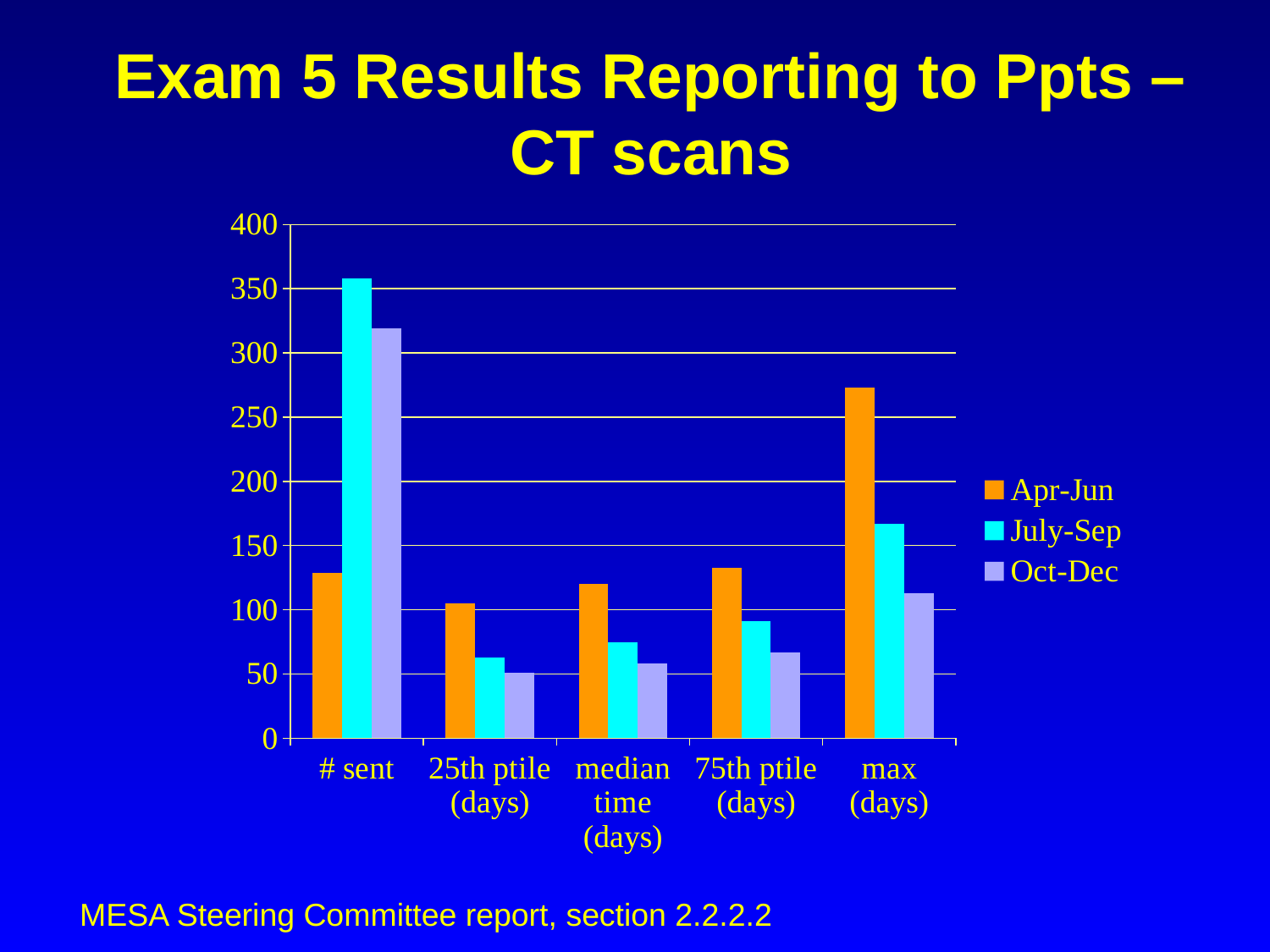
What is the title of the slide? Exam 5 Results Reporting to Ppts – CT scans Is the Apr-Jun value for 'max (days)' greater or less than 250? greater How many series does the legend list? 3 Which series has the lowest value for '# sent'? Apr-Jun What kind of chart is shown on the slide? bar chart Which series has the highest value for '# sent'? July-Sep Which is larger for 'median time (days)': the Apr-Jun value or the July-Sep value? Apr-Jun Is the Oct-Dec value for '25th ptile (days)' greater or less than 100? less How many categories are shown on the x axis? 5 Is the July-Sep value for '# sent' greater or less than 350? greater Which is larger for '# sent': the Oct-Dec value or the Apr-Jun value? Oct-Dec Which series has the highest value for 'max (days)'? Apr-Jun